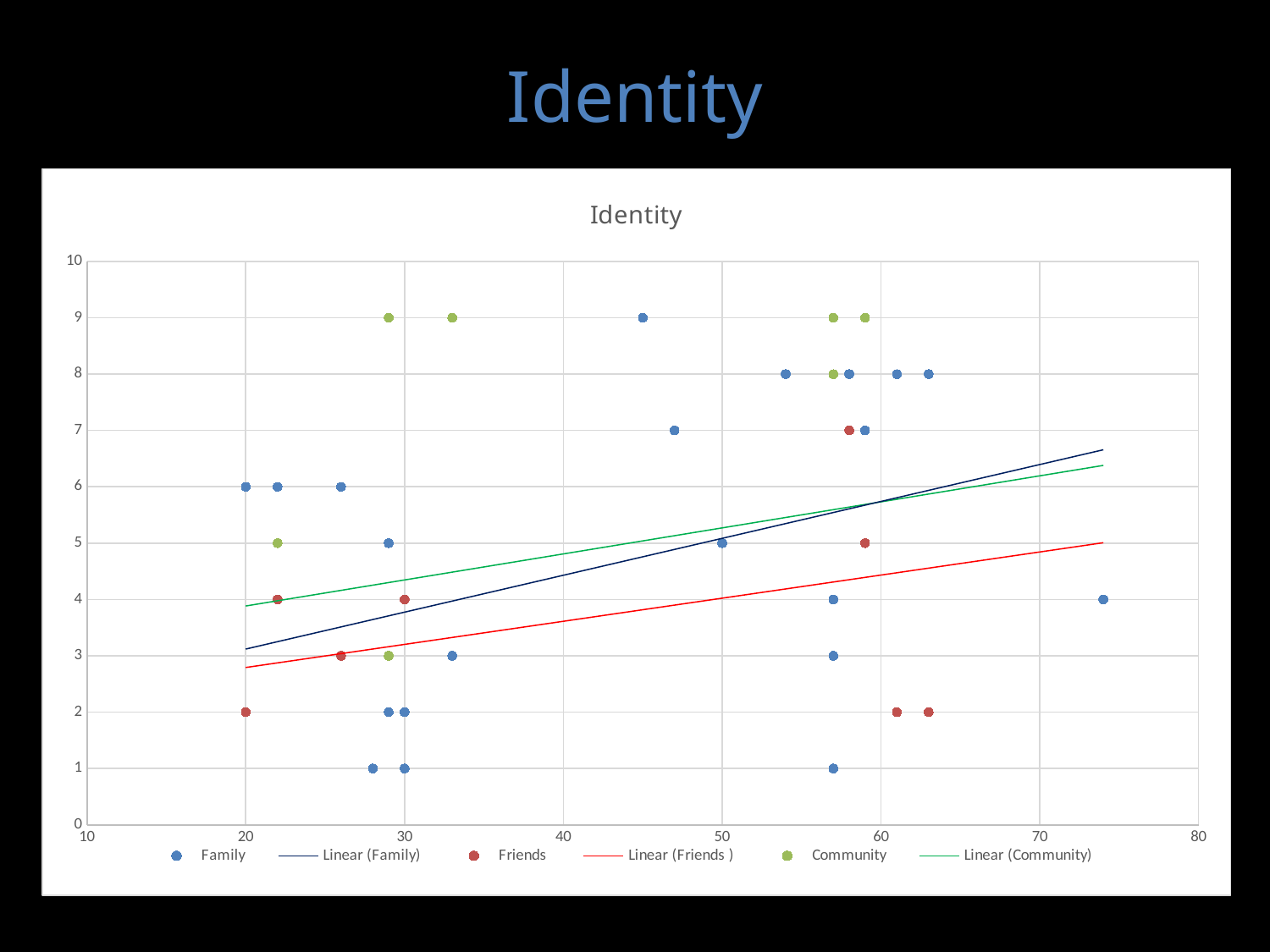
What is the highest y value reached by any plotted point? 9 What is the title of the chart? Identity How many entries does the chart legend list? 6 Is the Linear (Family) trendline at x = 20 greater or less than 4? less What is the maximum value shown on the y axis? 10 What is the lowest y value reached by any plotted point? 1 Is the Linear (Friends) trendline at x = 80 greater or less than 6? less Is the Linear (Community) trendline at x = 20 greater or less than 3? greater What kind of chart is shown on the slide? scatter chart Which colour marks the Friends series in the chart? red Which trendline is the lowest at x = 80? Linear (Friends) Do the linear trendlines rise or fall as the x value increases? rise